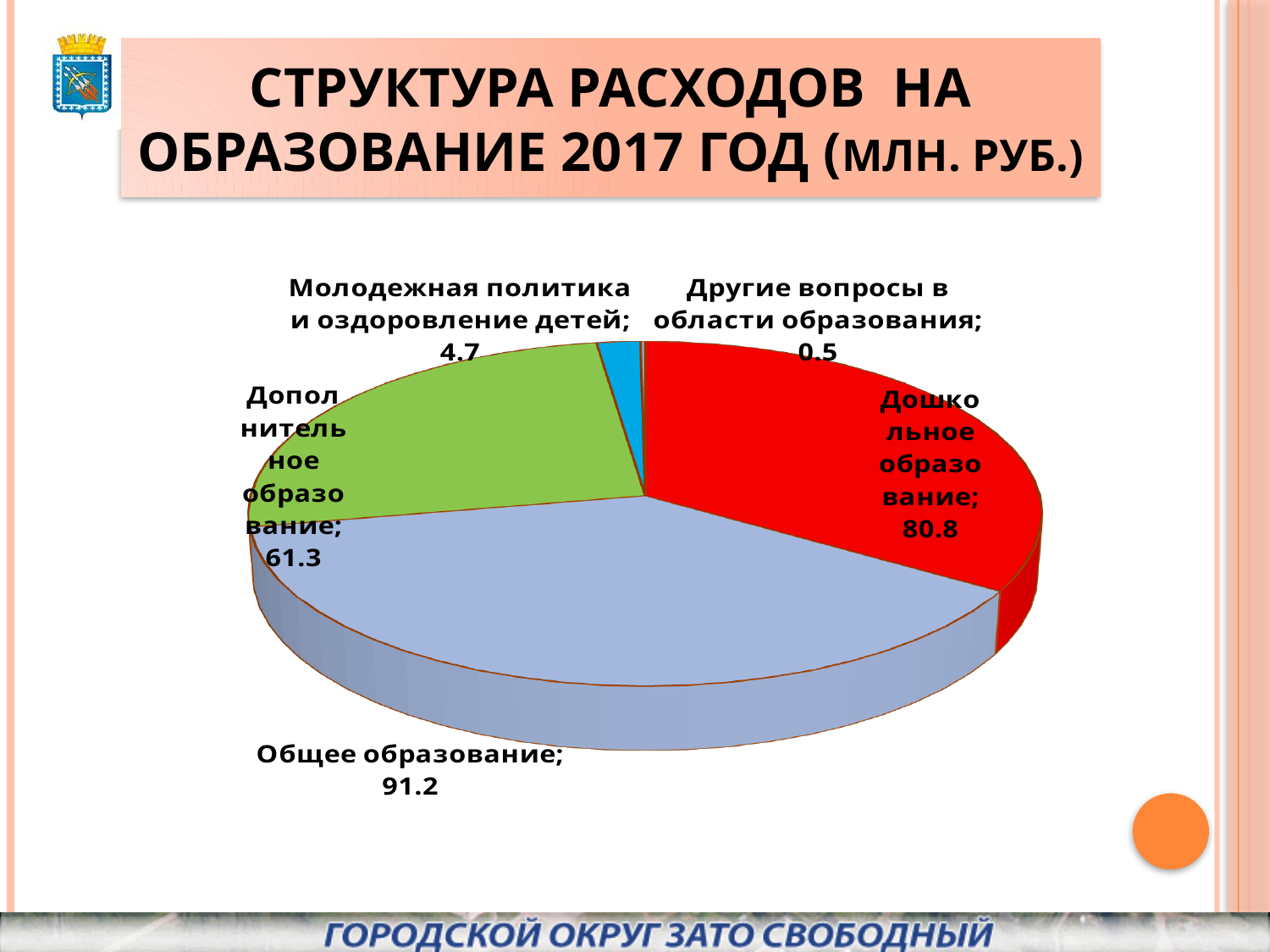
What is the value for Дополнительное образование? 61.3 What is the title of the chart on the slide? Структура расходов на образование 2017 год (млн. руб.) Which category has the smallest slice of the pie? Другие вопросы в области образования What is the value for Другие вопросы в области образования? 0.5 How many categories does the pie chart show? 5 What is the value for Молодежная политика и оздоровление детей? 4.7 Which category has the largest slice of the pie? Общее образование What kind of chart is shown on the slide? Pie chart Which is larger, Дошкольное образование or Дополнительное образование? Дошкольное образование What is the value for Дошкольное образование? 80.8 What is the difference between the values for Общее образование and Дошкольное образование? 10.4 What is the value for Общее образование? 91.2